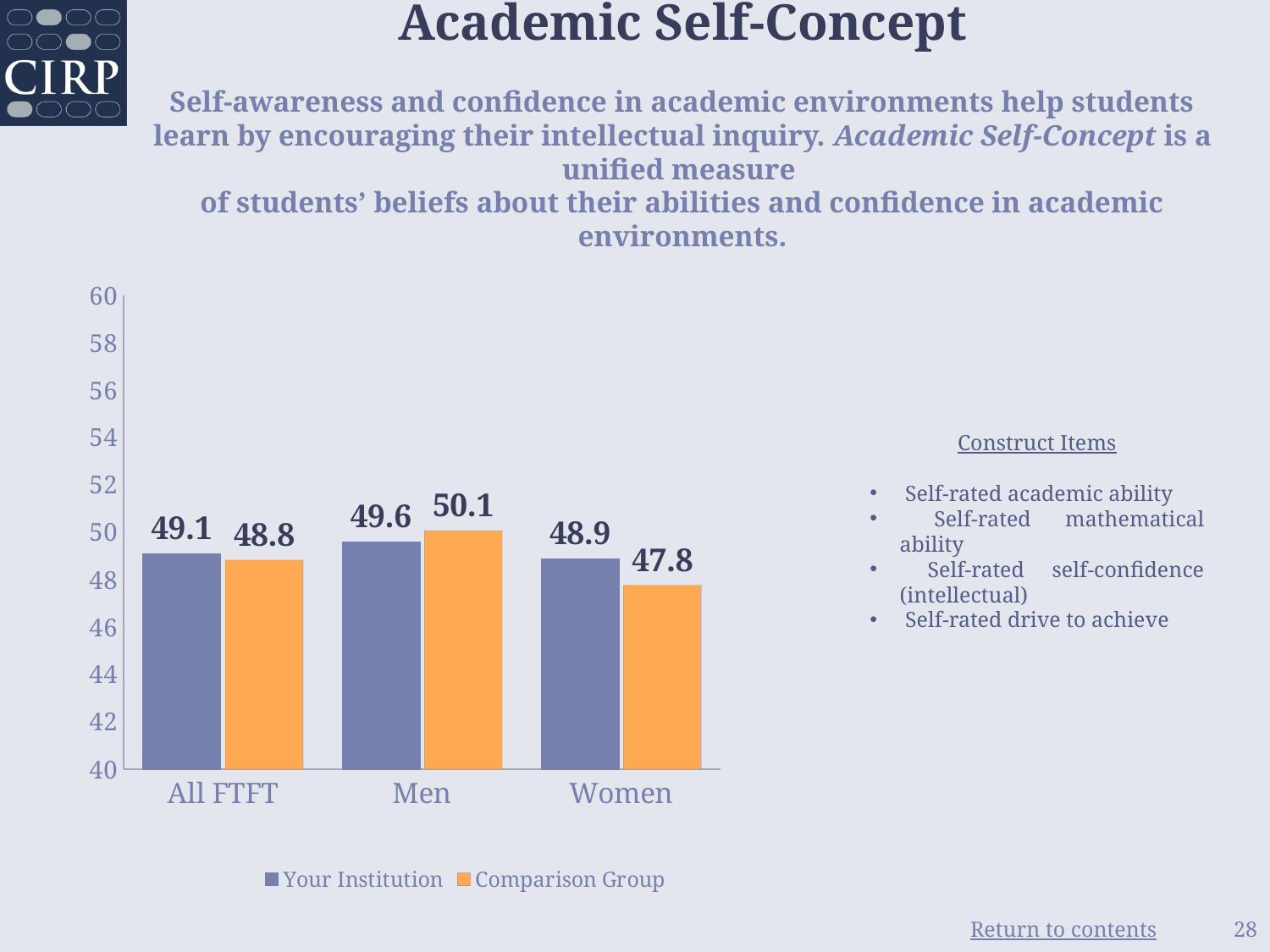
What is the value for Your Institution in the Men category? 49.6 What is the difference between Your Institution and the Comparison Group in the Women category? 1.1 How many series does the legend list? 2 What colour are the Comparison Group bars? orange Which category has the lowest Your Institution value? Women Which category has the highest Comparison Group value? Men In the Men category, which is larger: Your Institution or the Comparison Group? Comparison Group What is the value for Your Institution in the All FTFT category? 49.1 What is the value for the Comparison Group in the Women category? 47.8 What kind of chart is shown on the slide? bar chart Is the Comparison Group value for Women greater or less than 50? less How many categories are shown on the x axis? 3